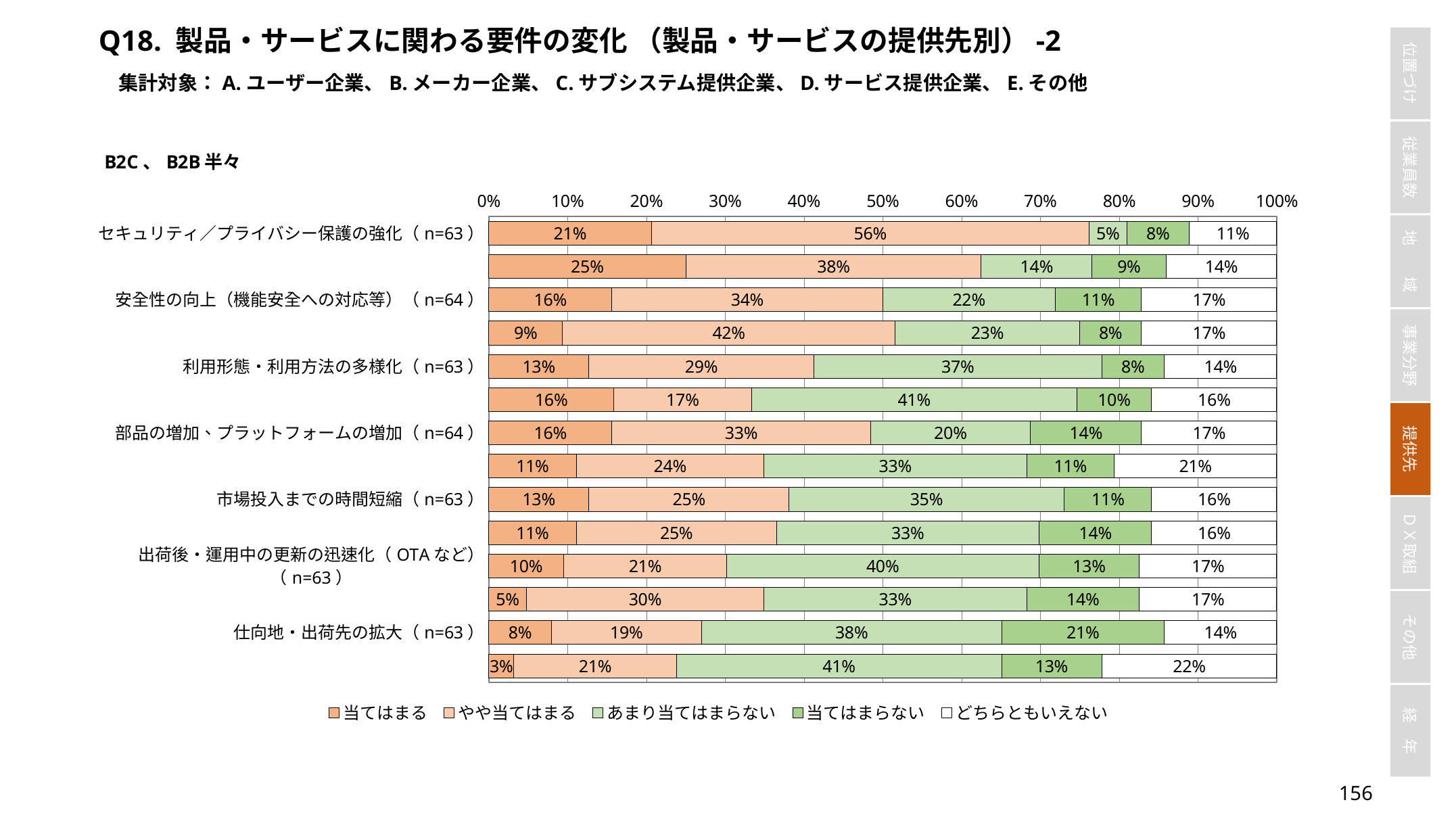
How many category labels are shown on the vertical axis of the chart? 7 In the bar labeled 部品の増加、プラットフォームの増加（n=64）, what is the value for どちらともいえない? 17% In the bar labeled 仕向地・出荷先の拡大（n=63）, what is the value for 当てはまらない? 21% Among the labeled bars, which category has the lowest 当てはまる value? 仕向地・出荷先の拡大（n=63） Which is larger: the 当てはまらない value in the bar labeled 仕向地・出荷先の拡大（n=63） or the 当てはまらない value in the bar labeled 利用形態・利用方法の多様化（n=63）? 仕向地・出荷先の拡大（n=63） In the bar labeled 出荷後・運用中の更新の迅速化（OTAなど）（n=63）, what is the value for あまり当てはまらない? 40% How many series does the legend list? 5 In the bar labeled セキュリティ／プライバシー保護の強化（n=63）, what is the combined value of 当てはまる and やや当てはまる? 77% What is the difference between the やや当てはまる value in the bar labeled セキュリティ／プライバシー保護の強化（n=63） and the やや当てはまる value in the bar labeled 安全性の向上（機能安全への対応等）（n=64）? 22 percentage points Among the labeled bars, which category has the highest 当てはまる value? セキュリティ／プライバシー保護の強化（n=63） In the bar labeled セキュリティ／プライバシー保護の強化（n=63）, what is the value for 当てはまる? 21% What kind of chart is shown on the slide? Stacked bar chart